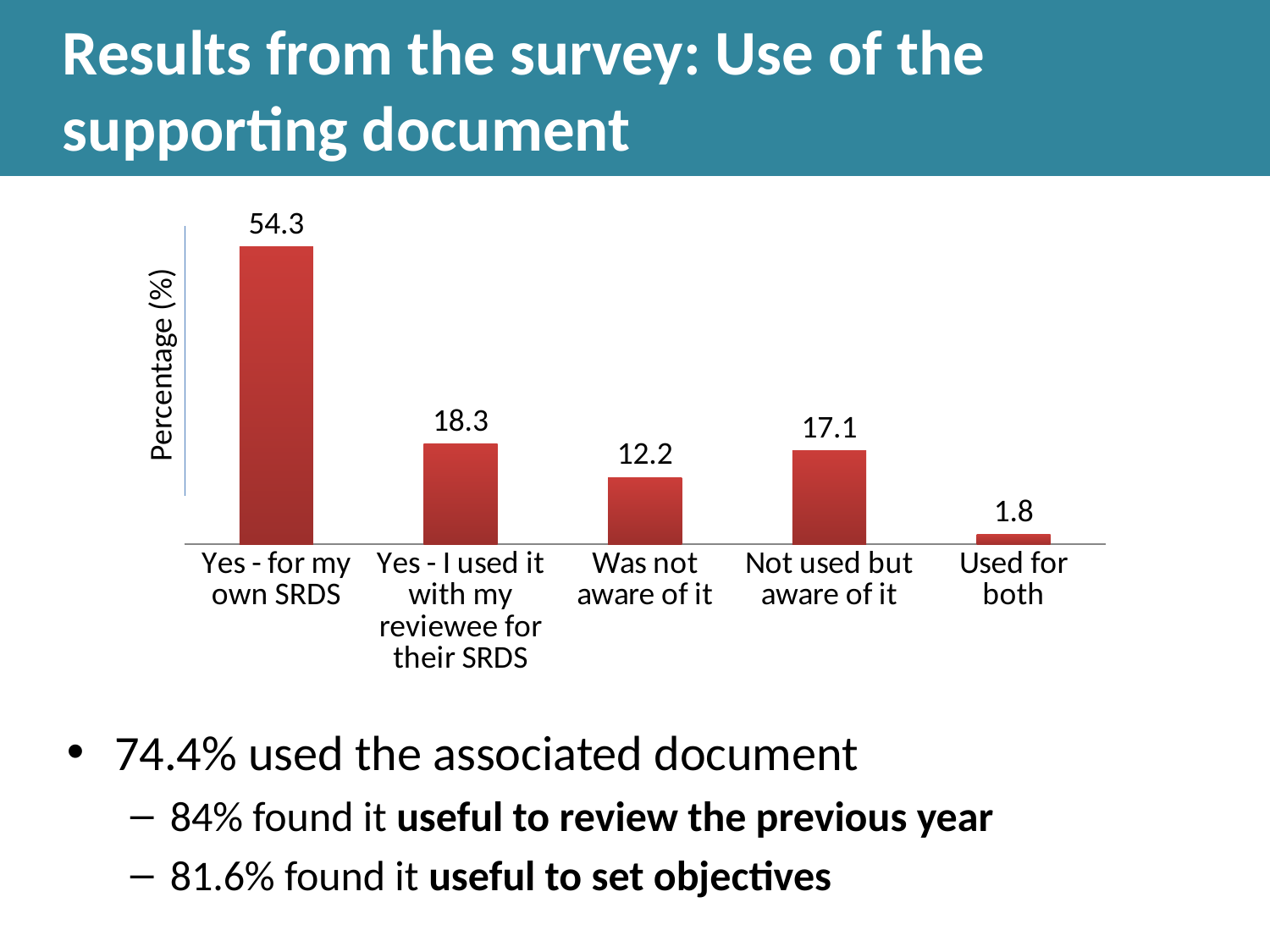
What kind of chart is shown on the slide? Bar chart What is the label of the vertical axis? Percentage (%) What is the value for "Yes - for my own SRDS"? 54.3 How many categories are shown on the x axis? 5 What is the value for "Not used but aware of it"? 17.1 What is the value for "Used for both"? 1.8 Which category has the lowest value? Used for both Which category has the highest value? Yes - for my own SRDS What is the difference between the values for "Not used but aware of it" and "Was not aware of it"? 4.9 Which is larger: the value for "Yes - I used it with my reviewee for their SRDS" or the value for "Not used but aware of it"? Yes - I used it with my reviewee for their SRDS What is the value for "Was not aware of it"? 12.2 What is the difference between the values for "Yes - for my own SRDS" and "Yes - I used it with my reviewee for their SRDS"? 36.0